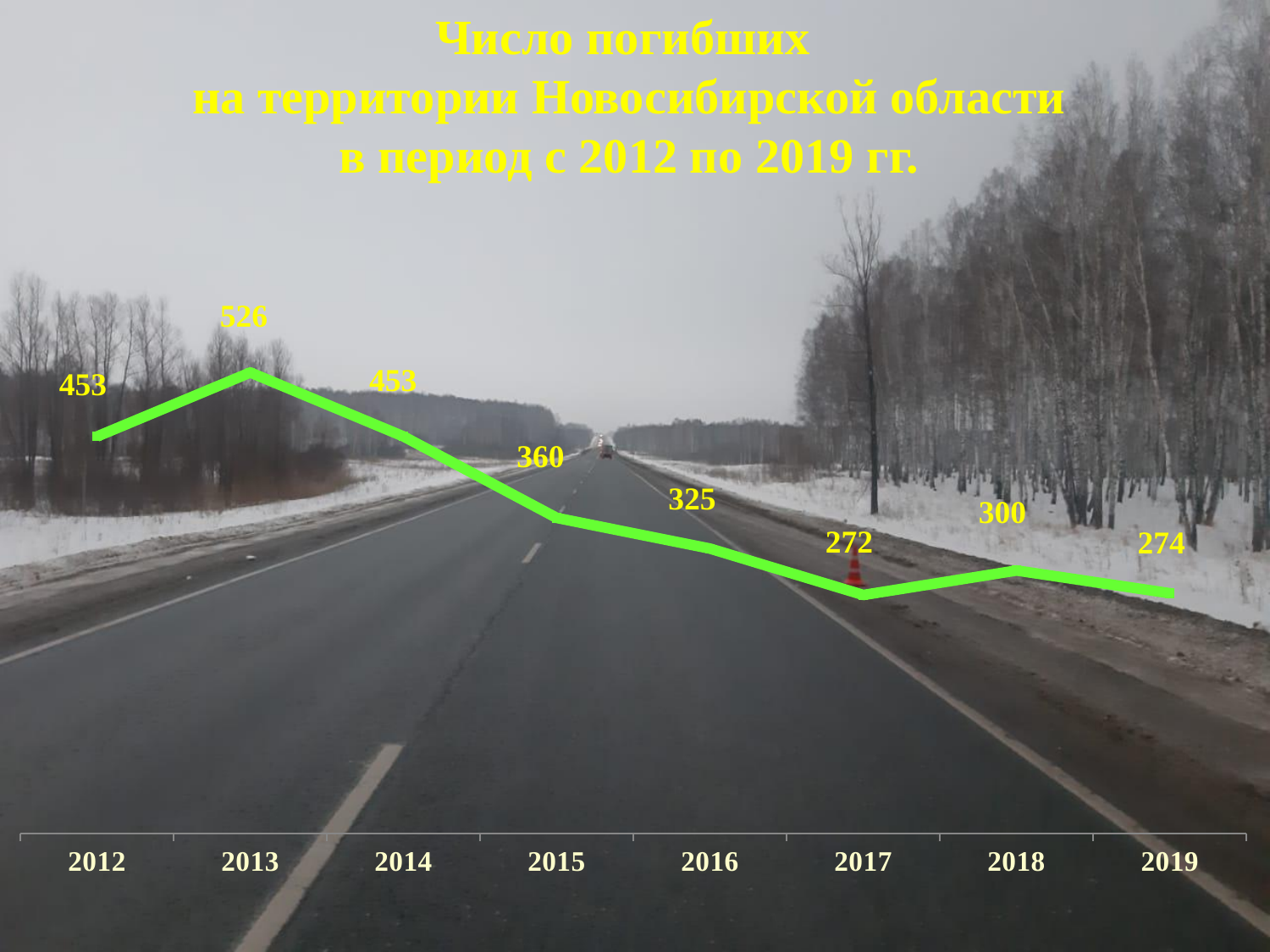
What is the value for 2019? 274 What is the difference between the values for 2013 and 2014? 73 Does the number of deaths generally rise or fall from 2013 to 2019? fall What is the number of deaths in 2017? 272 What is the difference between the values for 2012 and 2019? 179 What is the number of deaths in 2013? 526 Which is larger, the value for 2015 or the value for 2016? 2015 What colour is the line on the chart? green Which year has the lowest number of deaths? 2017 Which year has the highest number of deaths? 2013 How many years are plotted on the chart? 8 What type of chart is shown on the slide? line chart